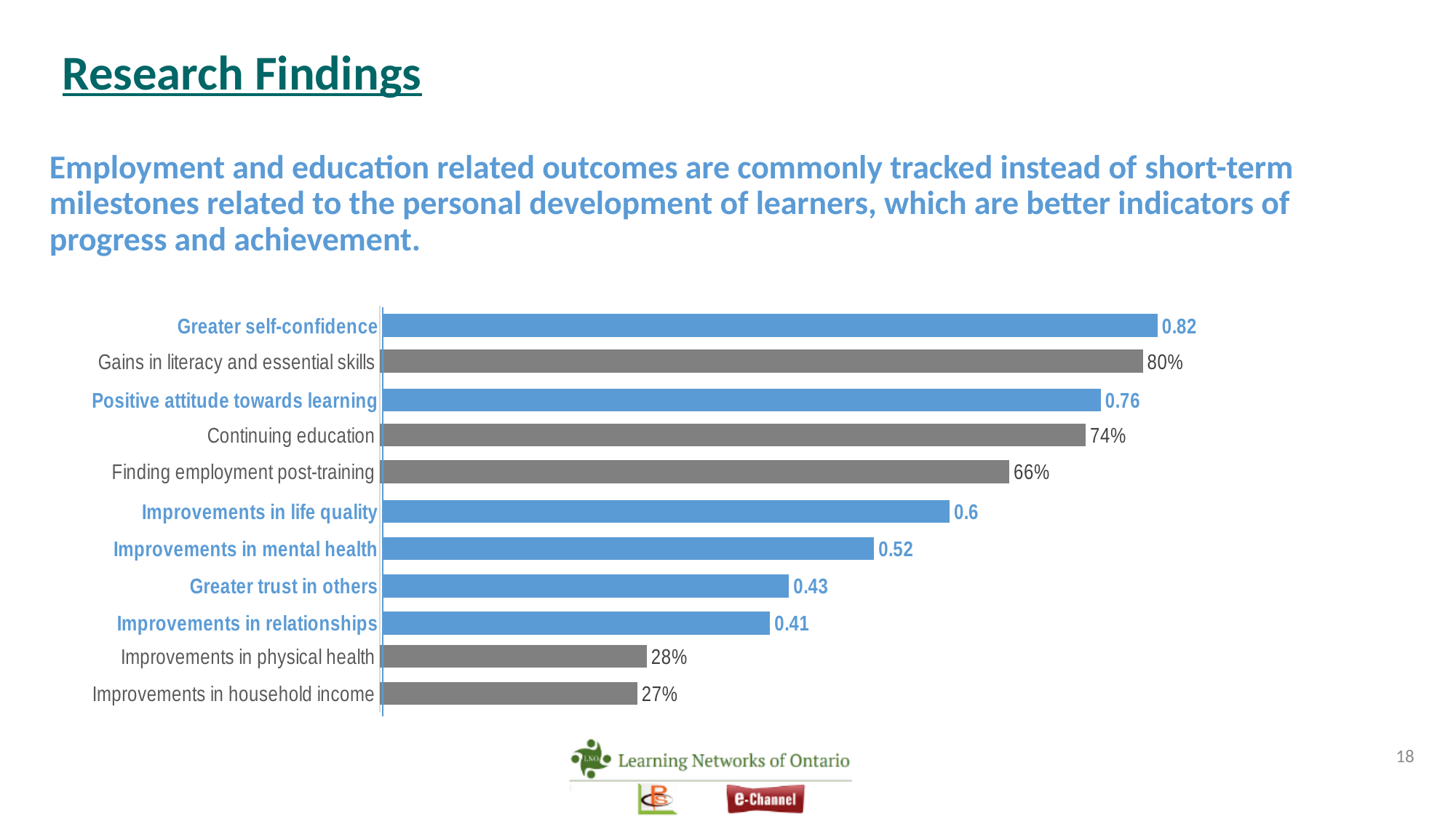
What is the difference between the values for Greater self-confidence and Positive attitude towards learning? 0.06 What is the difference between the values for Gains in literacy and essential skills and Continuing education? 6% How many categories are shown in the chart? 11 What is the value shown for Gains in literacy and essential skills? 80% What is the value shown for Greater self-confidence? 0.82 Which category has the longest bar? Greater self-confidence What is the value shown for Finding employment post-training? 66% Which category has the shortest bar? Improvements in household income Which has a larger value, Improvements in life quality or Greater trust in others? Improvements in life quality What is the value shown for Improvements in household income? 27% What kind of chart is shown on the slide? Bar chart What is the value shown for Improvements in mental health? 0.52